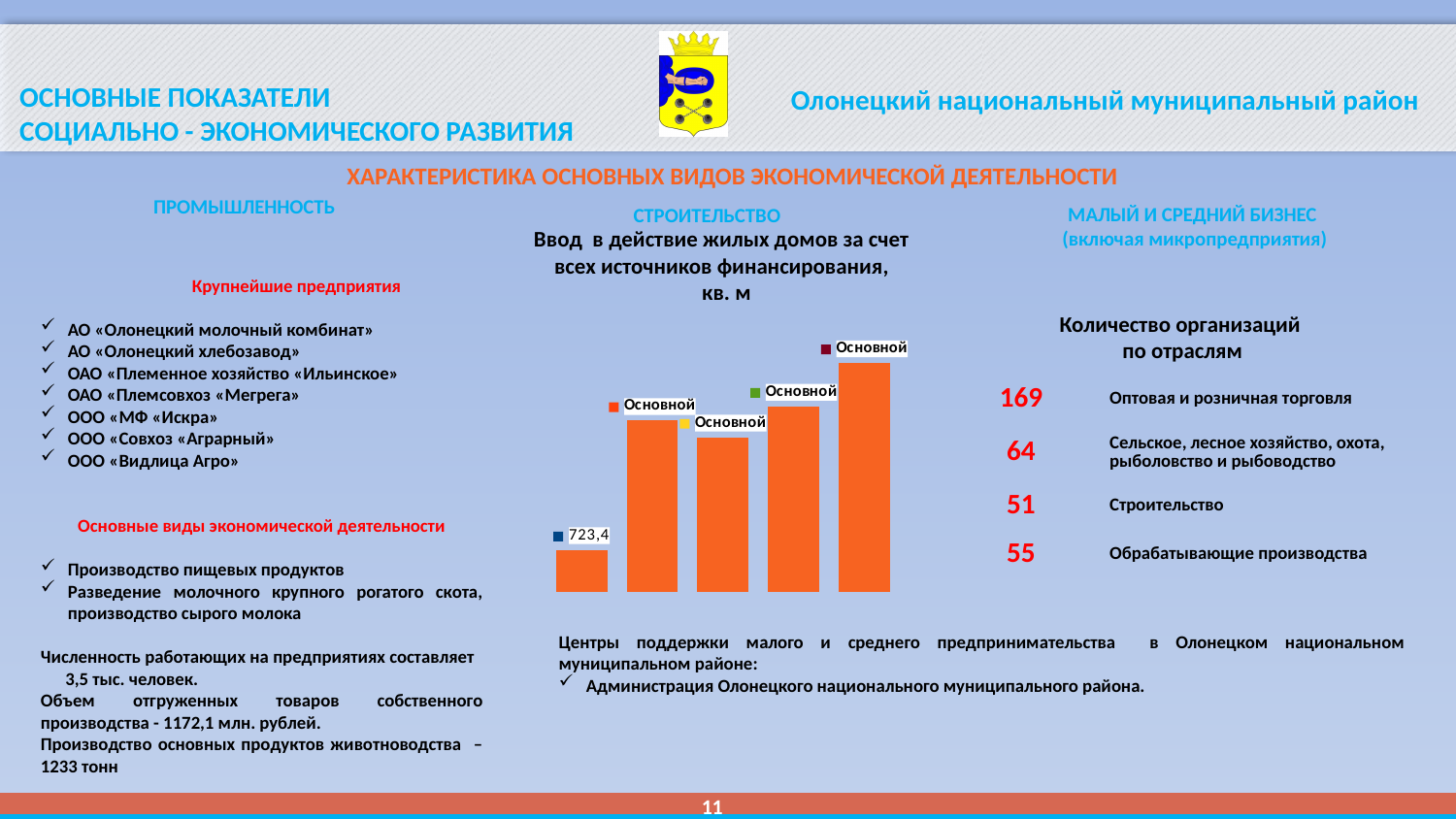
What unit is named in the chart's title? кв. м What kind of chart is shown under the heading "Ввод в действие жилых домов за счет всех источников финансирования, кв. м"? bar chart Which bar in the chart is the shortest? the leftmost (first) bar Which bar in the chart is the tallest? the rightmost (fifth) bar What value is printed on the leftmost bar of the chart? 723,4 Which is taller in the chart, the first bar or the third bar? the third bar What colour are the bars in the chart? orange Do the bar heights in the chart generally rise or fall from left to right? rise Which is taller in the chart, the fourth bar or the fifth bar? the fifth bar How many bars does the chart on the slide contain? 5 Which is taller in the chart, the second bar or the third bar? the second bar